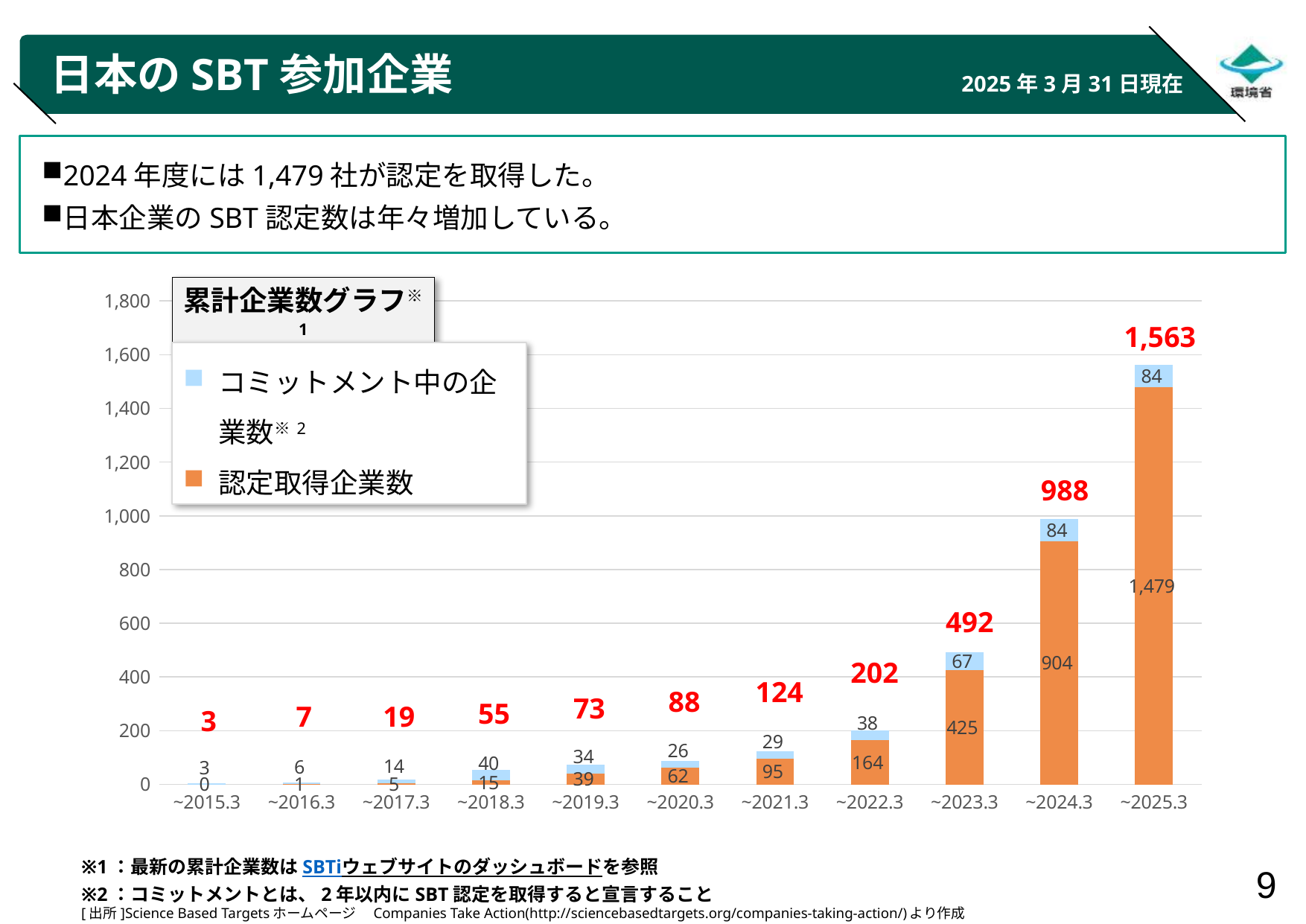
Which category has the lowest total? ~2015.3 How many categories are shown on the x axis of the chart? 11 What is the total of the stacked bar for ~2024.3? 988 What is the value of 認定取得企業数 for ~2025.3? 1,479 What is the value of 認定取得企業数 for ~2022.3? 164 Do the total values rise or fall from ~2015.3 to ~2025.3? rise What is the value of コミットメント中の企業数 for ~2023.3? 67 How many series does the chart legend list? 2 What is the difference between 認定取得企業数 for ~2025.3 and ~2024.3? 575 What type of chart is shown on the slide? bar chart Which is larger for ~2018.3: コミットメント中の企業数 or 認定取得企業数? コミットメント中の企業数 Which category has the highest total? ~2025.3